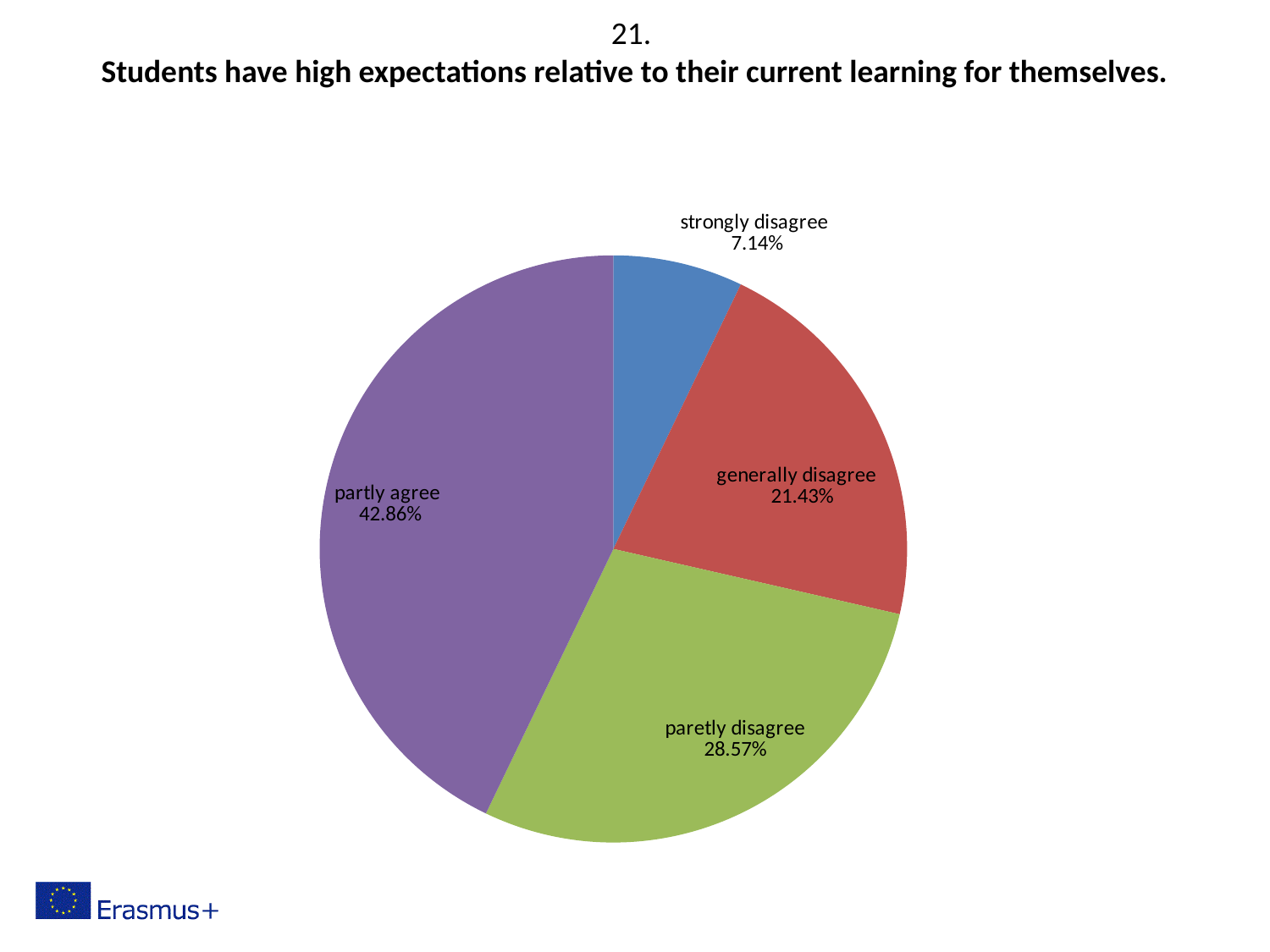
What percentage of respondents chose 'partly agree'? 42.86% How many slices does the pie chart have? 4 What colour is the 'partly agree' slice? purple Which is larger, the share for 'generally disagree' or the share for 'paretly disagree'? paretly disagree What kind of chart is shown on the slide? pie chart What is the difference in percentage points between 'generally disagree' and 'strongly disagree'? 14.29 What percentage of respondents chose 'generally disagree'? 21.43% Which response category has the smallest share of the pie? strongly disagree Which response category has the largest share of the pie? partly agree What percentage of respondents chose 'strongly disagree'? 7.14% What percentage of respondents chose 'paretly disagree'? 28.57% What is the difference in percentage points between 'partly agree' and 'paretly disagree'? 14.29